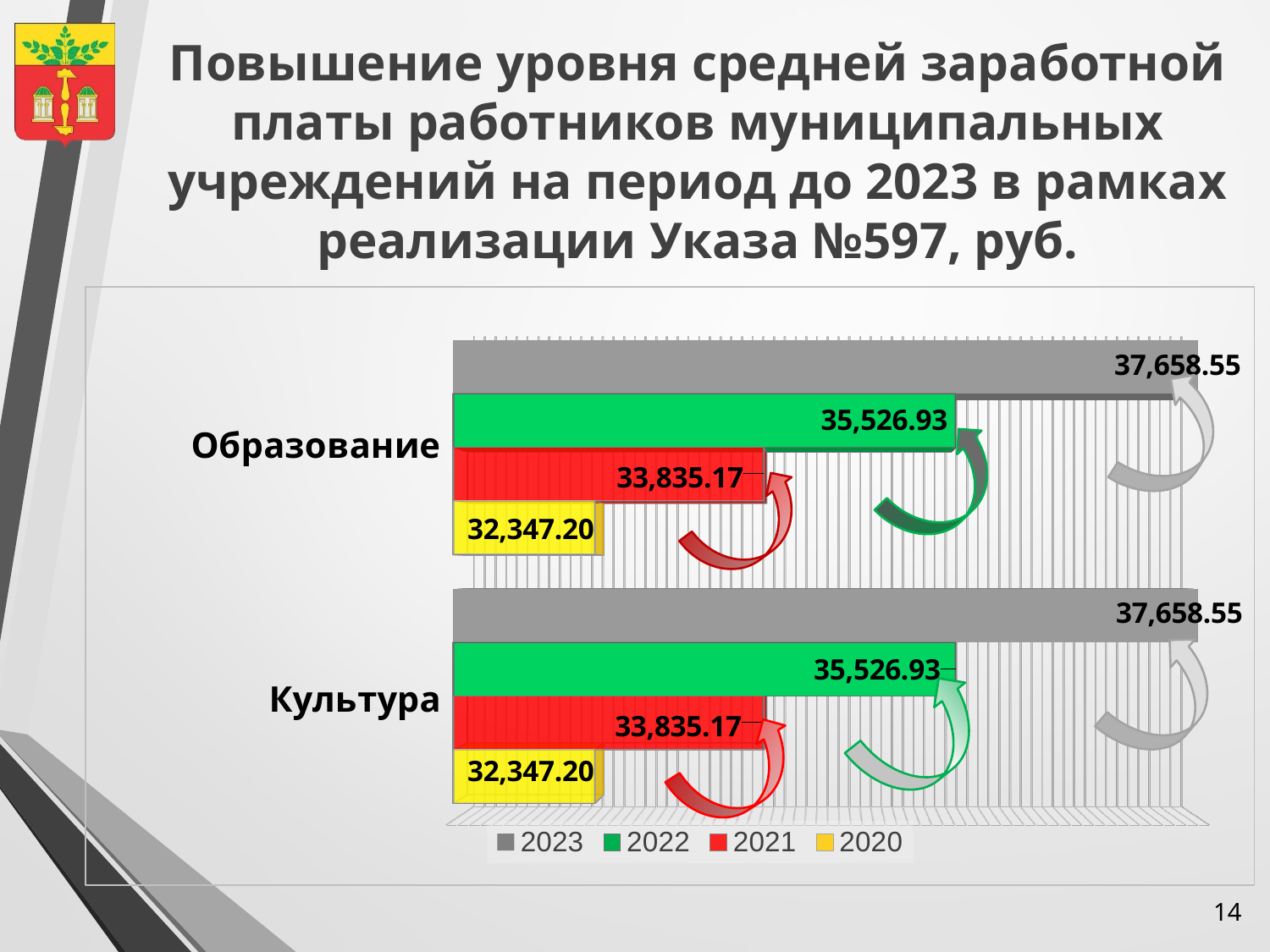
Which year has the highest value in the Культура category? 2023 Which is larger for Культура: the 2021 value or the 2022 value? 2022 How many series does the legend list? 4 What is the value for 2021 in the Образование category? 33,835.17 What is the difference between the 2023 and 2020 values for Культура? 5,311.35 How many categories are shown on the chart? 2 Which year has the lowest value in the Образование category? 2020 What is the value for 2023 in the Образование category? 37,658.55 What is the value for 2020 in the Культура category? 32,347.20 What is the value for 2022 in the Культура category? 35,526.93 What kind of chart is shown on the slide? Bar chart What is the difference between the 2023 and 2022 values for Образование? 2,131.62